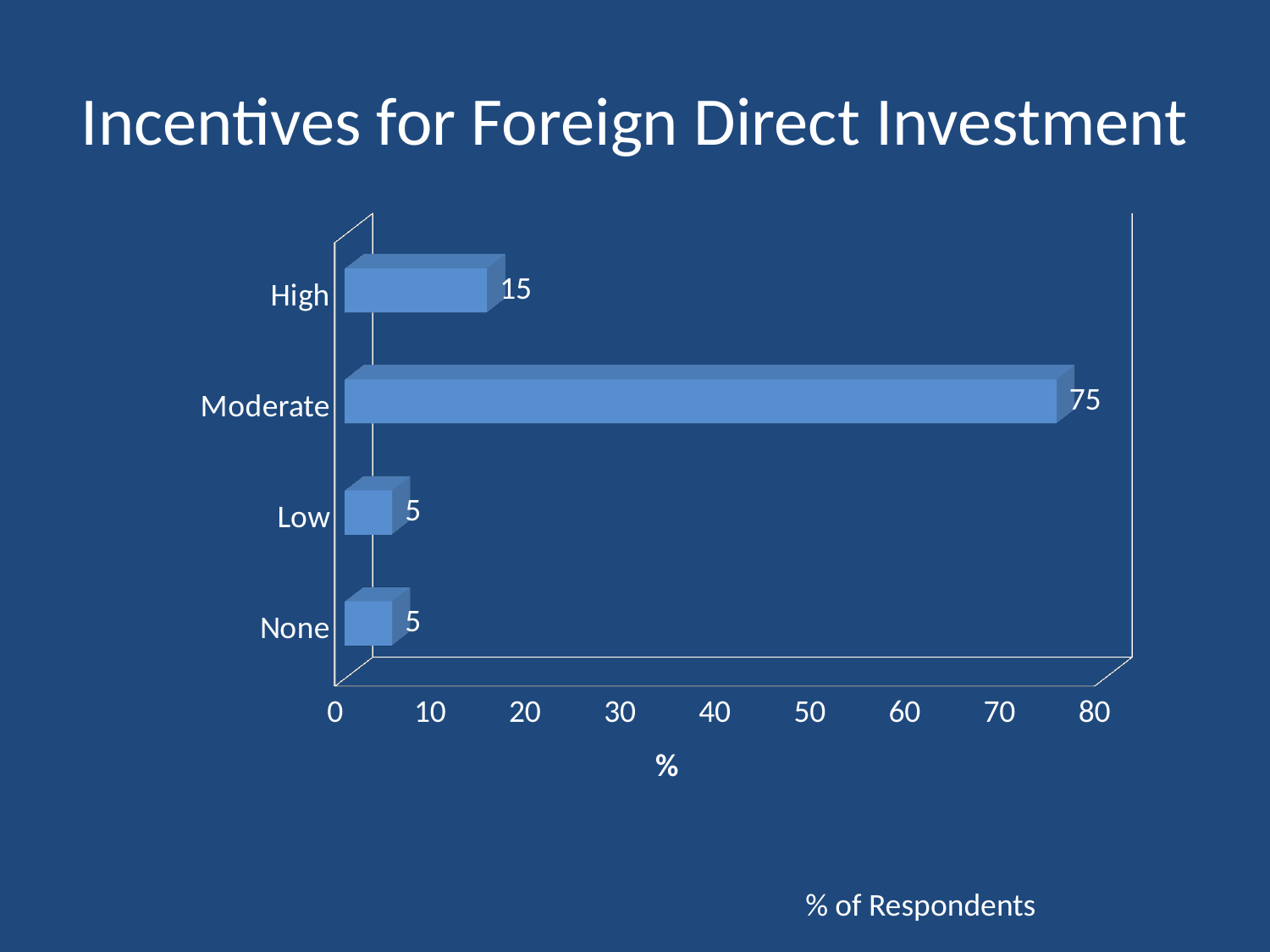
Which category has the highest value? Moderate How many categories are shown on the chart? 4 What is the value for None? 5 What is the title of the slide? Incentives for Foreign Direct Investment Is the value for Moderate greater or less than 70? greater What is the value for Low? 5 What is the difference between the values for Moderate and High? 60 What kind of chart is shown on the slide? bar chart What is the label on the horizontal axis? % What is the value for Moderate? 75 What is the value for High? 15 Which is larger, the value for High or the value for Low? High